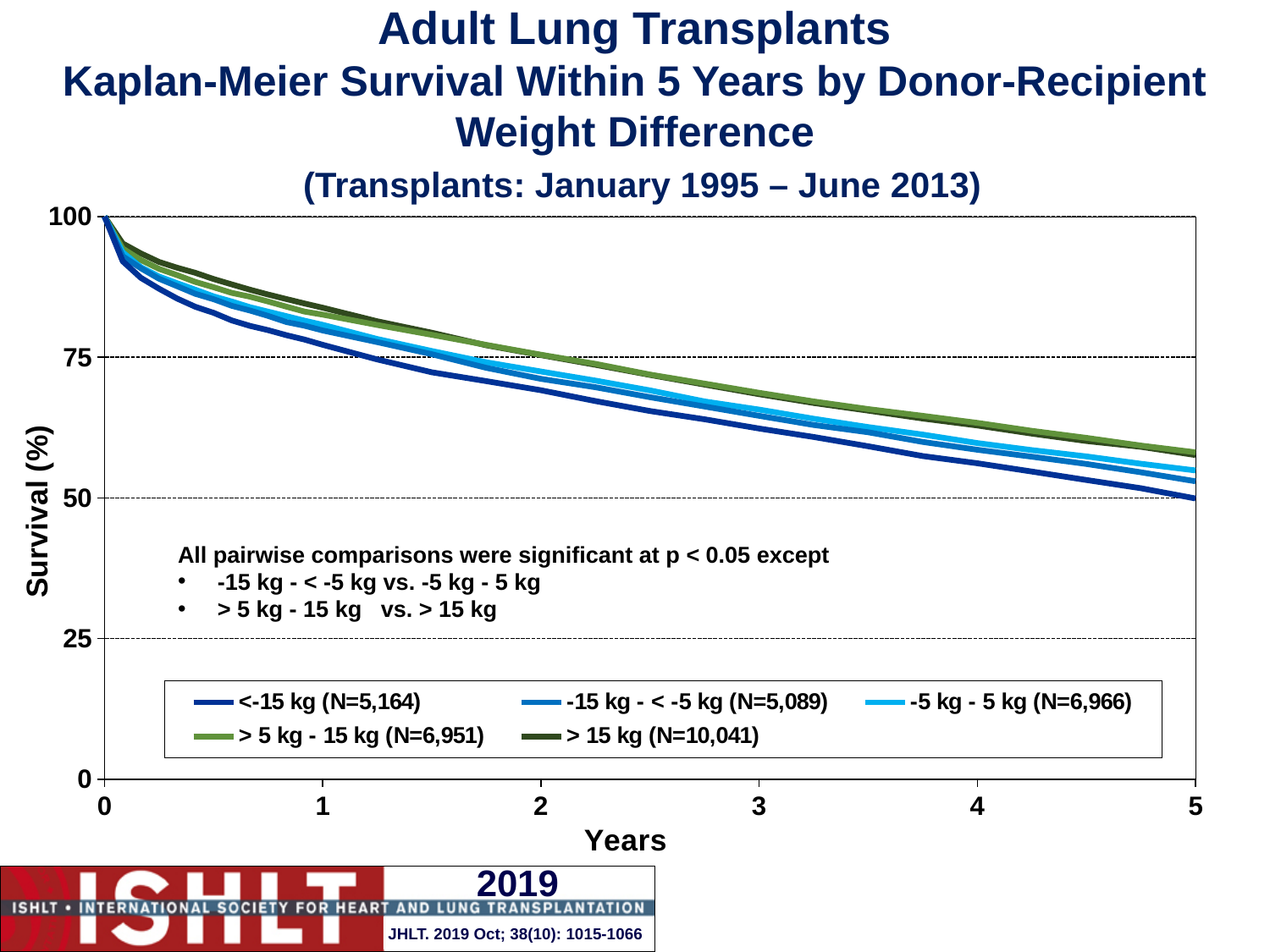
What is the N for the -5 kg - 5 kg group shown in the legend? 6,966 Is the survival for the > 15 kg group at 5 years greater or less than 50? greater Which group has the lowest survival curve across the 5 years? <-15 kg How many series does the legend list? 5 What is the N for the <-15 kg group shown in the legend? 5,164 At 3 years, which group has higher survival: <-15 kg or -5 kg - 5 kg? -5 kg - 5 kg Is the survival for the <-15 kg group at 2 years greater or less than 75? less What transplant date range is given in the chart title? January 1995 – June 2013 Do the survival curves rise or fall as years increase? fall What kind of chart is shown on the slide? line chart What is the N for the > 15 kg group shown in the legend? 10,041 What is the label of the y-axis? Survival (%)